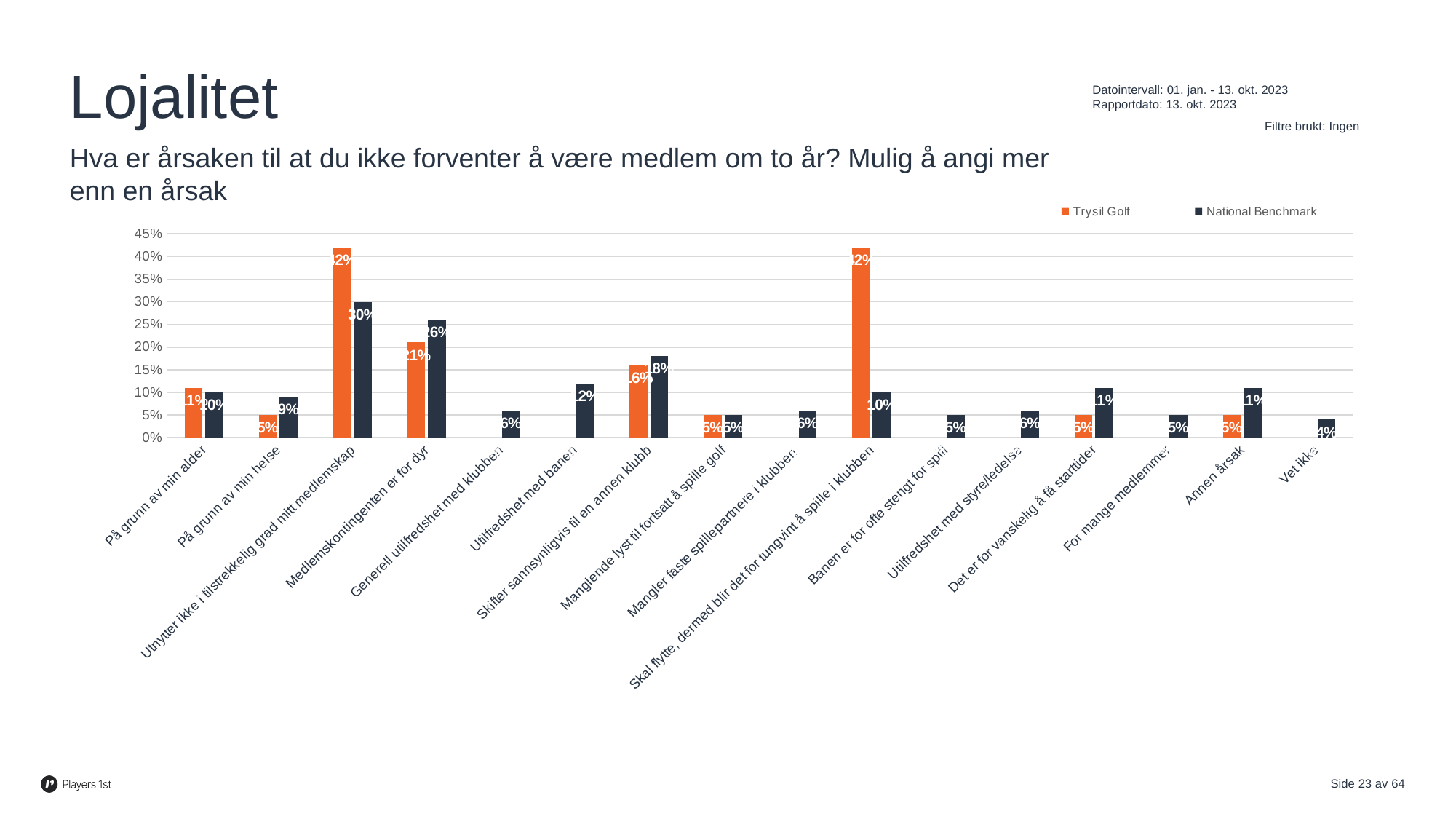
What is the National Benchmark value for 'Vet ikke'? 4% For 'Skifter sannsynligvis til en annen klubb', what is the difference between the National Benchmark (18%) and Trysil Golf (16%) values? 2 percentage points What is the National Benchmark value for 'Utnytter ikke i tilstrekkelig grad mitt medlemskap'? 30% What is the Trysil Golf value for 'Medlemskontingenten er for dyr'? 21% For 'Medlemskontingenten er for dyr', which is larger: Trysil Golf or National Benchmark? National Benchmark Which colour represents Trysil Golf in the legend? Orange What is the National Benchmark value for 'Medlemskontingenten er for dyr'? 26% Which category has the highest National Benchmark value? Utnytter ikke i tilstrekkelig grad mitt medlemskap Is the Trysil Golf value for 'Skal flytte, dermed blir det for tungvint å spille i klubben' greater or less than 40%? greater How many series does the legend list? 2 How many categories are shown on the x axis? 16 What kind of chart is shown on the slide? Bar chart